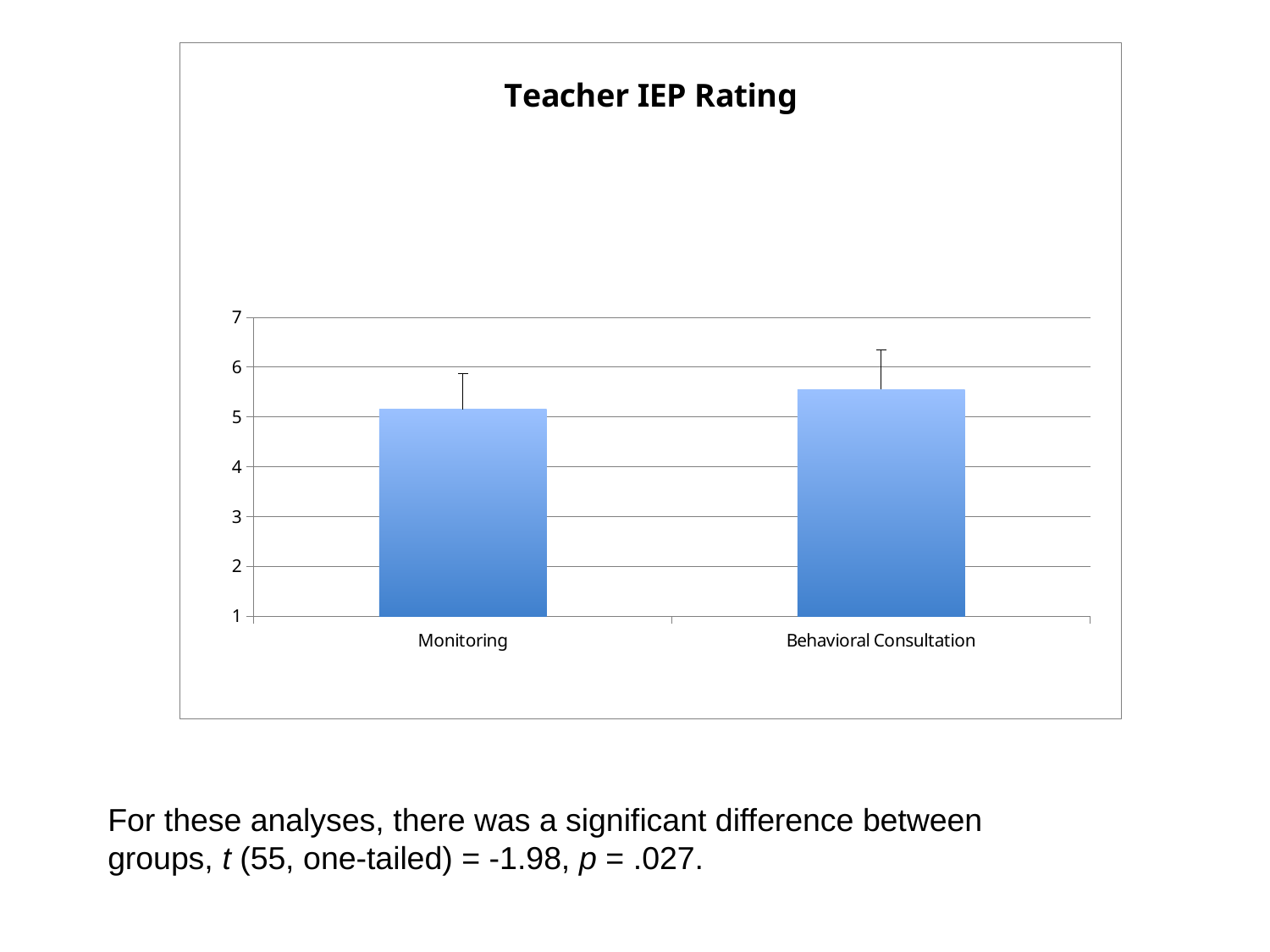
Is the value for Monitoring greater or less than 6? less Which category has the lowest Teacher IEP Rating? Monitoring What kind of chart is shown on the slide? bar chart What is the highest value shown on the vertical axis? 7 Is the value for Behavioral Consultation greater or less than 6? less Is the value for Monitoring greater or less than 4? greater What is the title of the chart? Teacher IEP Rating Which category has the highest Teacher IEP Rating? Behavioral Consultation How many categories are plotted in the chart? 2 Which is larger, the value for Monitoring or the value for Behavioral Consultation? Behavioral Consultation